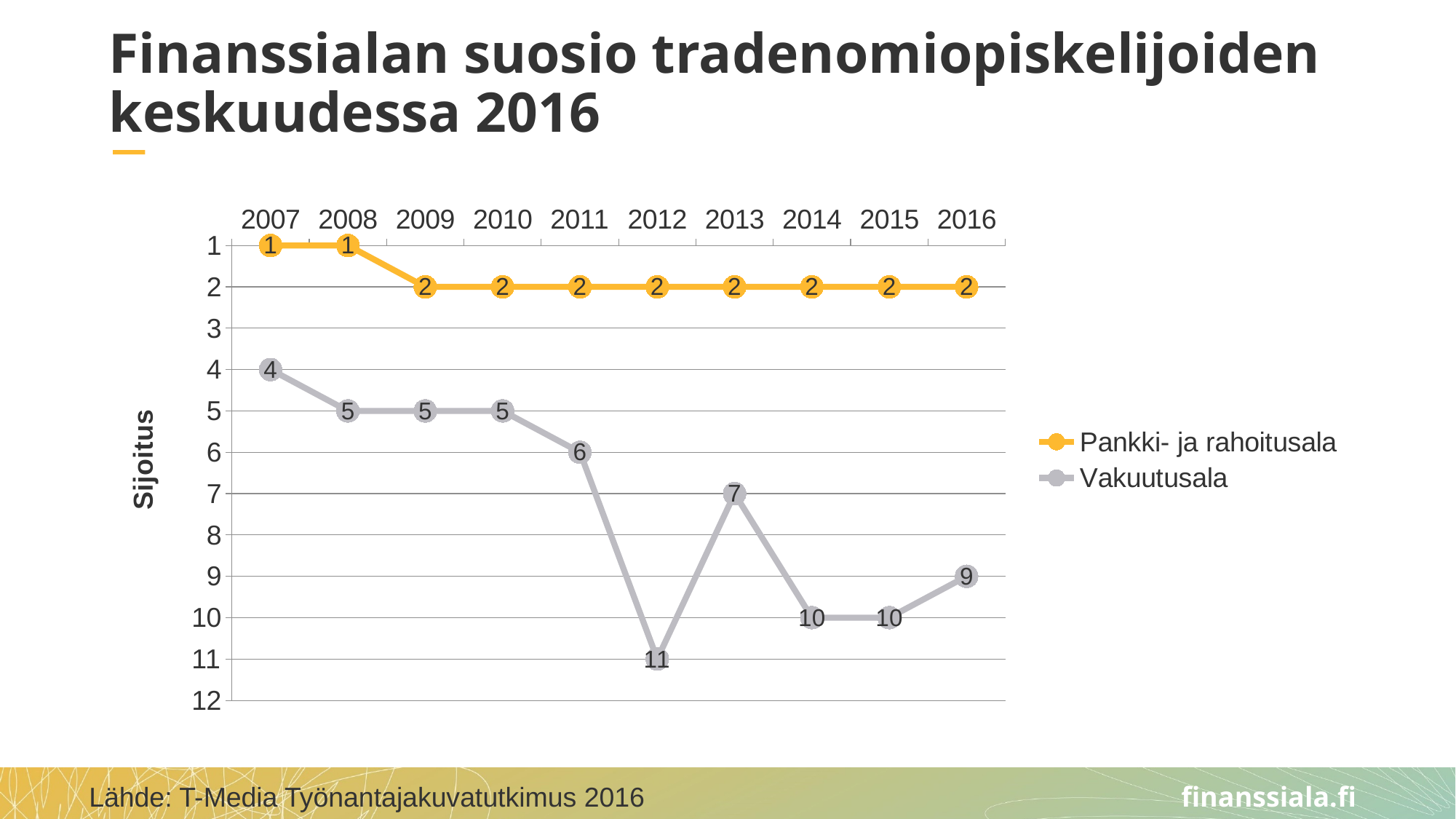
Which series has the larger plotted number in 2011, Pankki- ja rahoitusala or Vakuutusala? Vakuutusala How many years are plotted along the x axis? 10 What type of chart is shown on the slide? line chart How many series does the legend list? 2 In which year does Vakuutusala have its largest plotted number? 2012 What is the value for Vakuutusala in 2016? 9 What is the difference between the Vakuutusala value and the Pankki- ja rahoitusala value in 2014? 8 In which year does Vakuutusala have its smallest plotted number? 2007 What is the value for Pankki- ja rahoitusala in 2008? 1 What is the label of the y axis? Sijoitus What is the value for Vakuutusala in 2012? 11